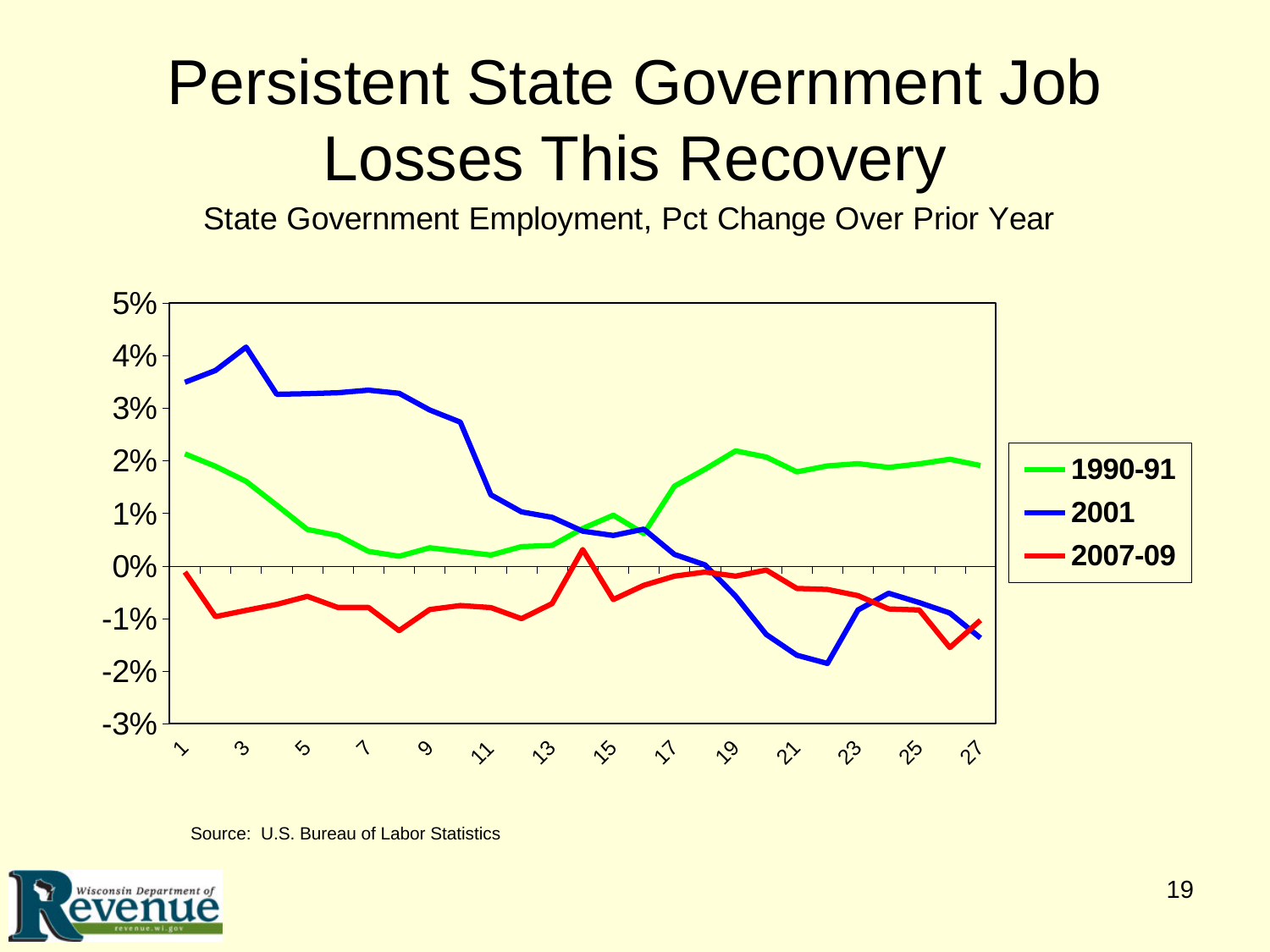
Which series reaches the lowest value anywhere on the chart? 2001 Is the value for the 2001 series at point 22 greater or less than -1%? less What are the three series named in the legend? 1990-91, 2001, 2007-09 At point 1, which series has the higher value, 2001 or 1990-91? 2001 At point 27, which series has the higher value, 1990-91 or 2007-09? 1990-91 What type of chart is shown on the slide? line chart Is the value for the 1990-91 series at point 8 greater or less than 1%? less How many series does the legend list? 3 Which series reaches the highest value anywhere on the chart? 2001 Is the value for the 2001 series at point 1 greater or less than 3%? greater Does the 2001 series overall rise or fall from point 1 to point 27? fall What is the highest value shown on the vertical axis? 5%